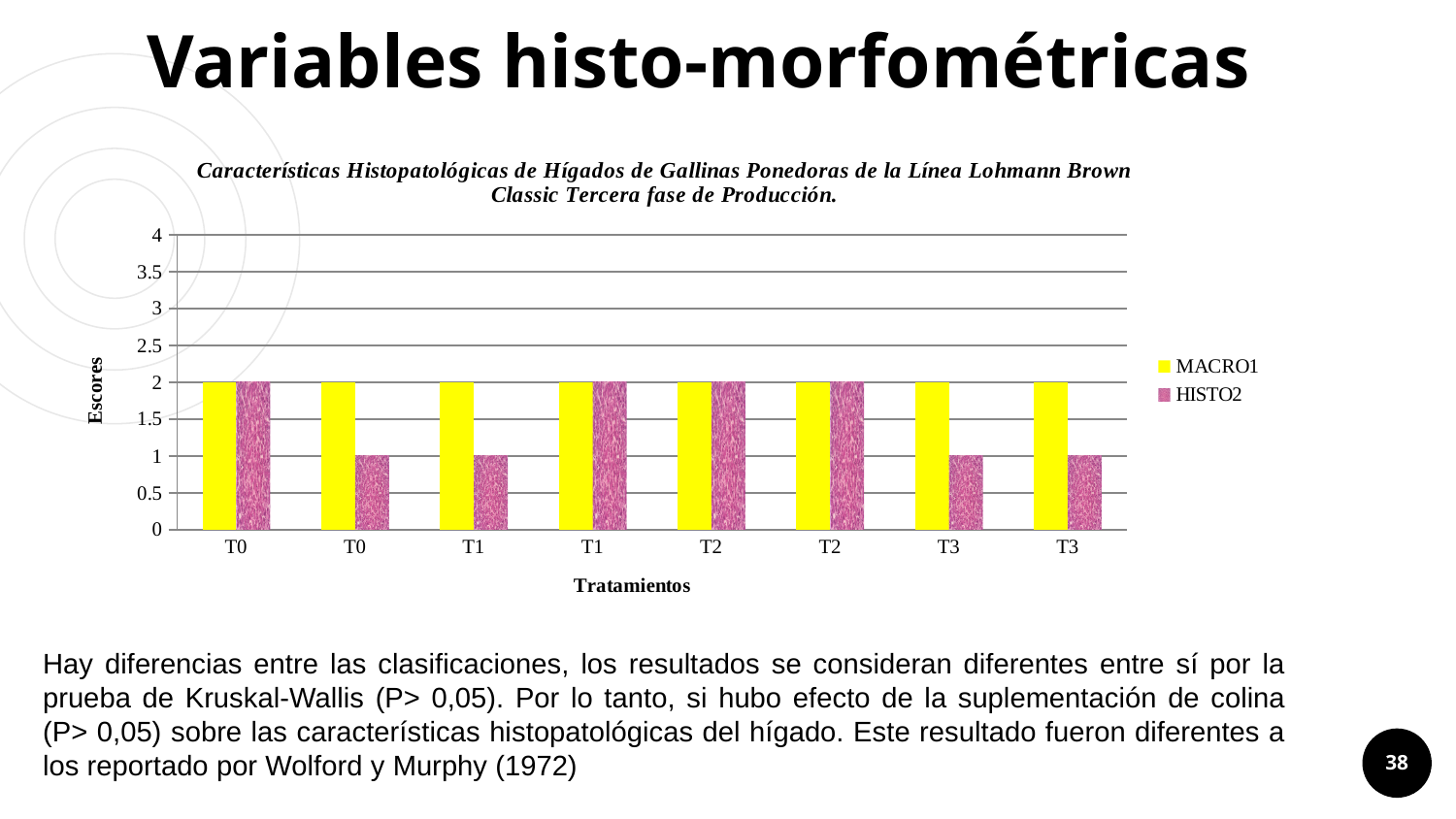
What is the HISTO2 value for the second T2 category (the sixth category from the left)? 2 What is the label of the y axis of the chart? Escores Is the MACRO1 value for the first T2 category (fifth from the left) greater or less than 3? less What is the HISTO2 value for the second T0 category (the second category from the left)? 1 What are the names of the series listed in the chart legend? MACRO1 and HISTO2 For the first T1 category (third from the left), which series has the larger value, MACRO1 or HISTO2? MACRO1 How many categories are shown along the x axis of the chart? 8 What is the difference between the MACRO1 and HISTO2 values for the first T3 category (seventh from the left)? 1 What is the HISTO2 value for the rightmost T3 category? 1 What kind of chart is shown on the slide? bar chart What is the MACRO1 value for the leftmost T0 category? 2 How many series does the chart legend list? 2